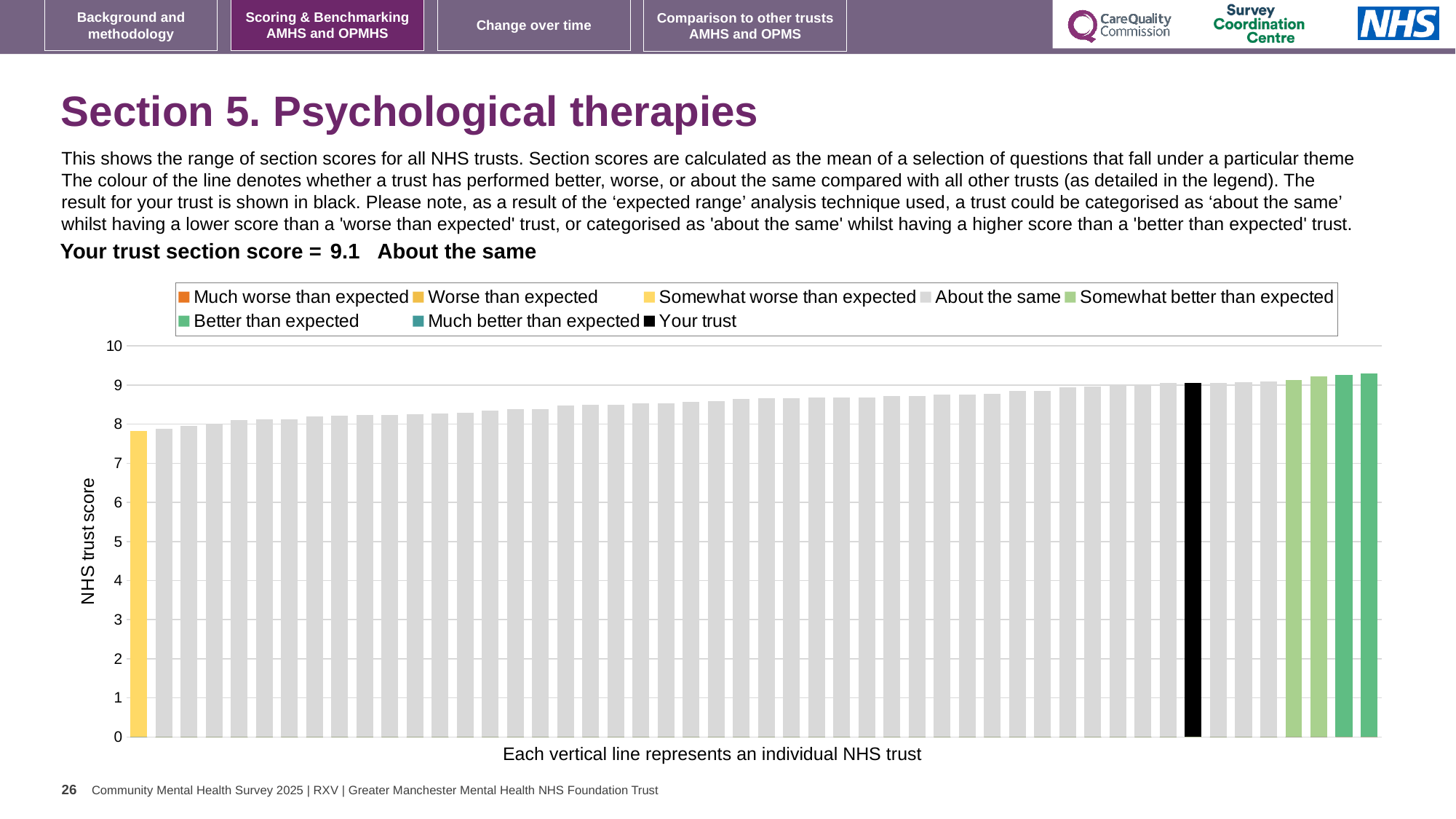
Is the value of the leftmost (yellow) bar greater or less than 9? less What is the label on the vertical axis of the chart? NHS trust score Is the value of the black bar (your trust) greater or less than 8? greater Do the bar values rise or fall moving from left to right along the x axis? rise How many entries does the chart legend list? 8 How many bars are coloured yellow (worse than expected)? 1 Is the value of the tallest bar on the right greater or less than 9? greater Is the black bar for your trust higher or lower than the yellow bar? higher What kind of chart is shown on the slide? bar chart How many bars are shown to the right of the black bar for your trust? 7 What is the section score for your trust shown on the slide? 9.1 Which benchmarking category is your trust placed in for this section? About the same